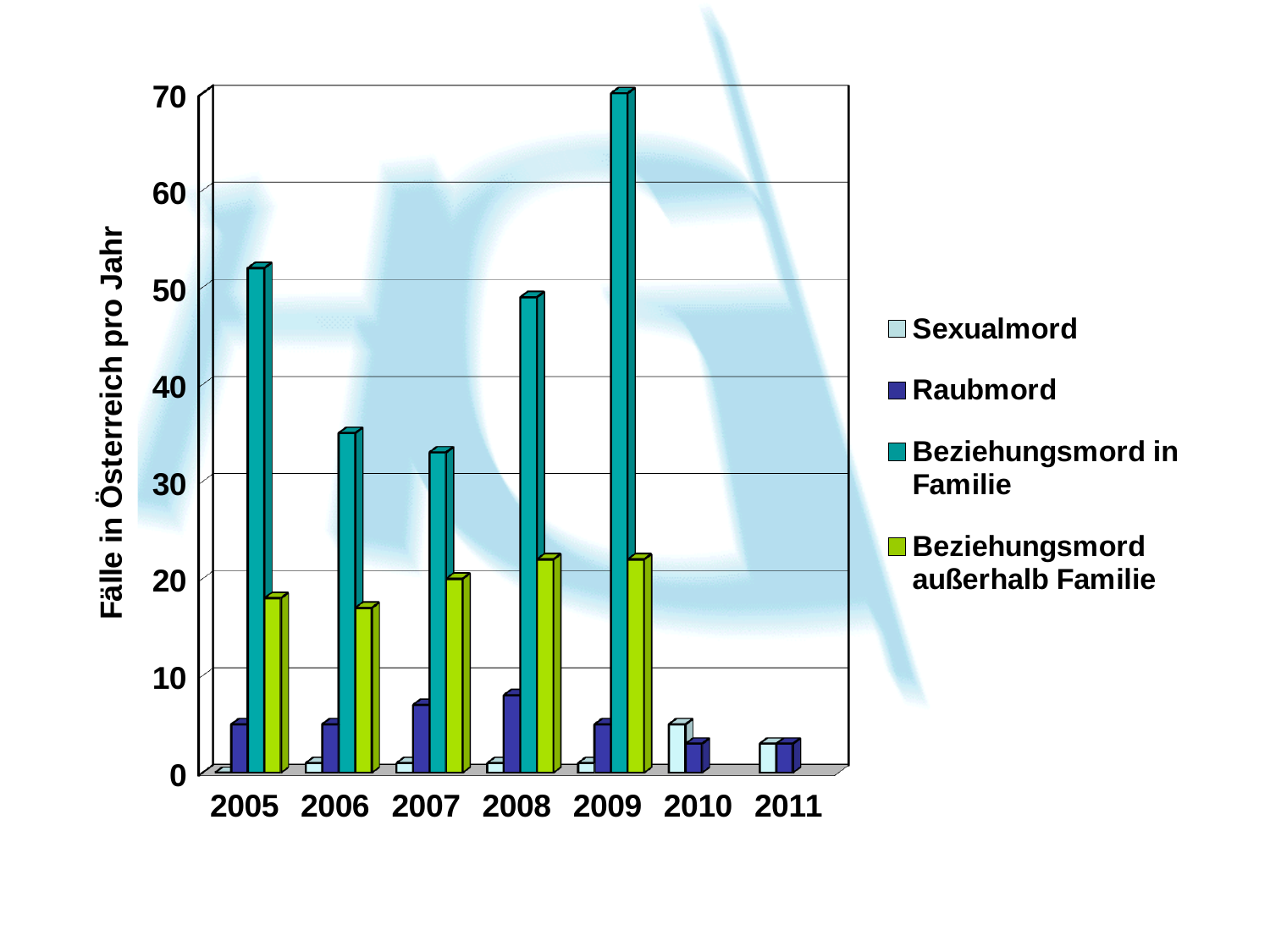
In which year is the Sexualmord bar the highest? 2010 Is the value for Beziehungsmord in Familie in 2008 greater or less than 40? greater Is the value for Beziehungsmord in Familie in 2006 greater or less than 40? less Is the value for Beziehungsmord außerhalb Familie in 2008 greater or less than 30? less What is the label of the chart's vertical axis? Fälle in Österreich pro Jahr In which year is the bar for Beziehungsmord in Familie the highest? 2009 In 2009, which is larger: Beziehungsmord in Familie or Beziehungsmord außerhalb Familie? Beziehungsmord in Familie Which is larger, the Beziehungsmord in Familie bar for 2005 or for 2006? 2005 How many years are shown on the x axis of the chart? 7 What kind of chart is shown on the slide? bar chart How many series does the chart's legend list? 4